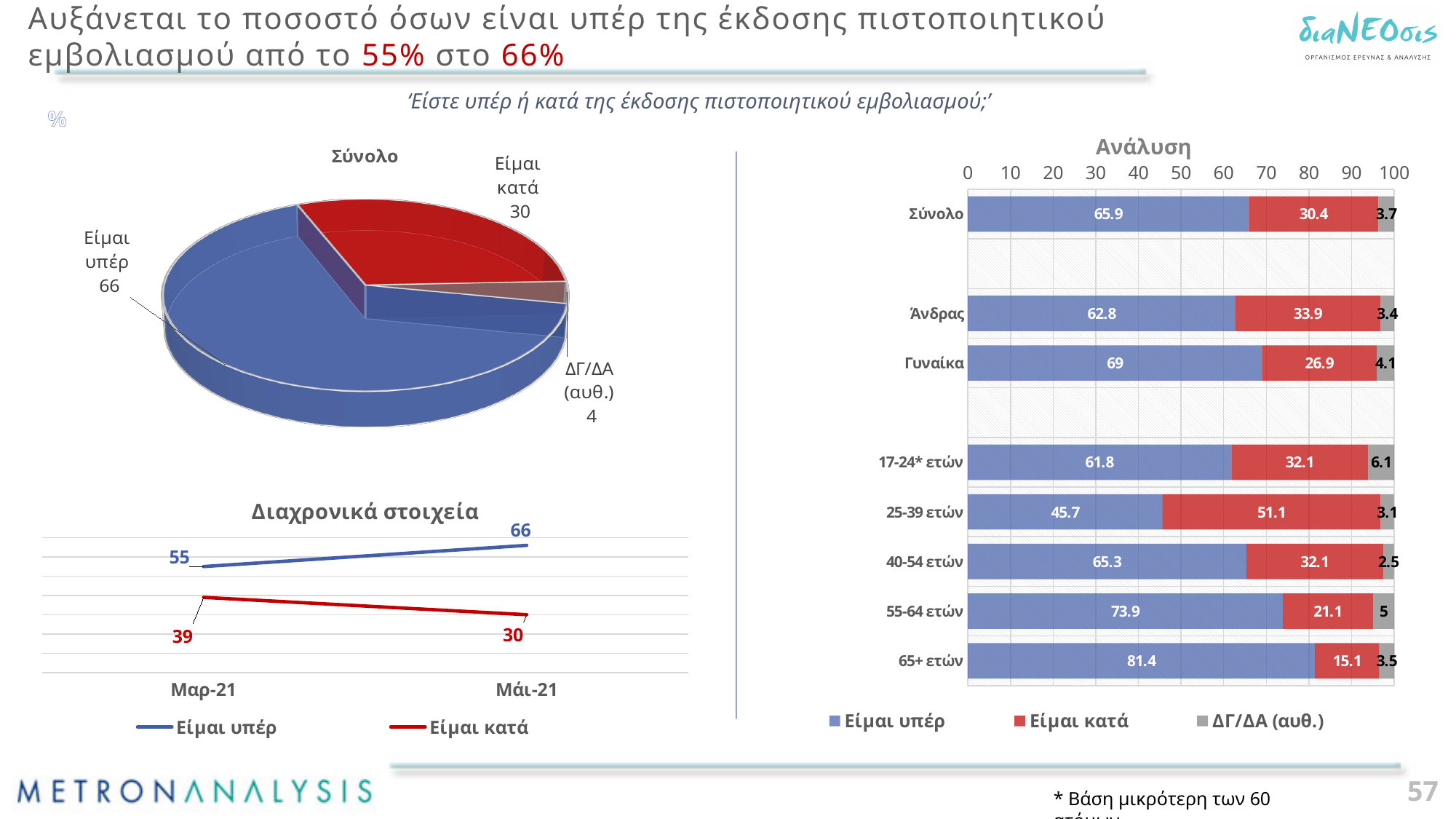
In the 'Ανάλυση' bar chart, what is the difference between the 'ΔΓ/ΔΑ (αυθ.)' values for '17-24* ετών' and '40-54 ετών'? 3.6 In the 'Σύνολο' pie chart, what is the value for 'Είμαι κατά'? 30 How many series does the legend of the 'Διαχρονικά στοιχεία' chart list? 2 In the 'Διαχρονικά στοιχεία' line chart, by how much did 'Είμαι υπέρ' change from Μαρ-21 to Μάι-21? 11 How many series does the legend of the 'Ανάλυση' bar chart list? 3 In the 'Διαχρονικά στοιχεία' line chart, what is the value for 'Είμαι υπέρ' at Μάι-21? 66 In the 'Σύνολο' pie chart, which slice is the smallest? ΔΓ/ΔΑ (αυθ.) What kind of chart is the 'Σύνολο' chart on the left of the slide? pie chart In the 'Ανάλυση' bar chart, which category has the lowest 'Είμαι υπέρ' value? 25-39 ετών In the 'Ανάλυση' bar chart, which has the larger 'Είμαι κατά' value, 'Άνδρας' or 'Γυναίκα'? Άνδρας In the 'Ανάλυση' bar chart, what is the 'Είμαι υπέρ' value for '65+ ετών'? 81.4 In the 'Διαχρονικά στοιχεία' line chart, does the 'Είμαι κατά' line rise or fall from Μαρ-21 to Μάι-21? fall